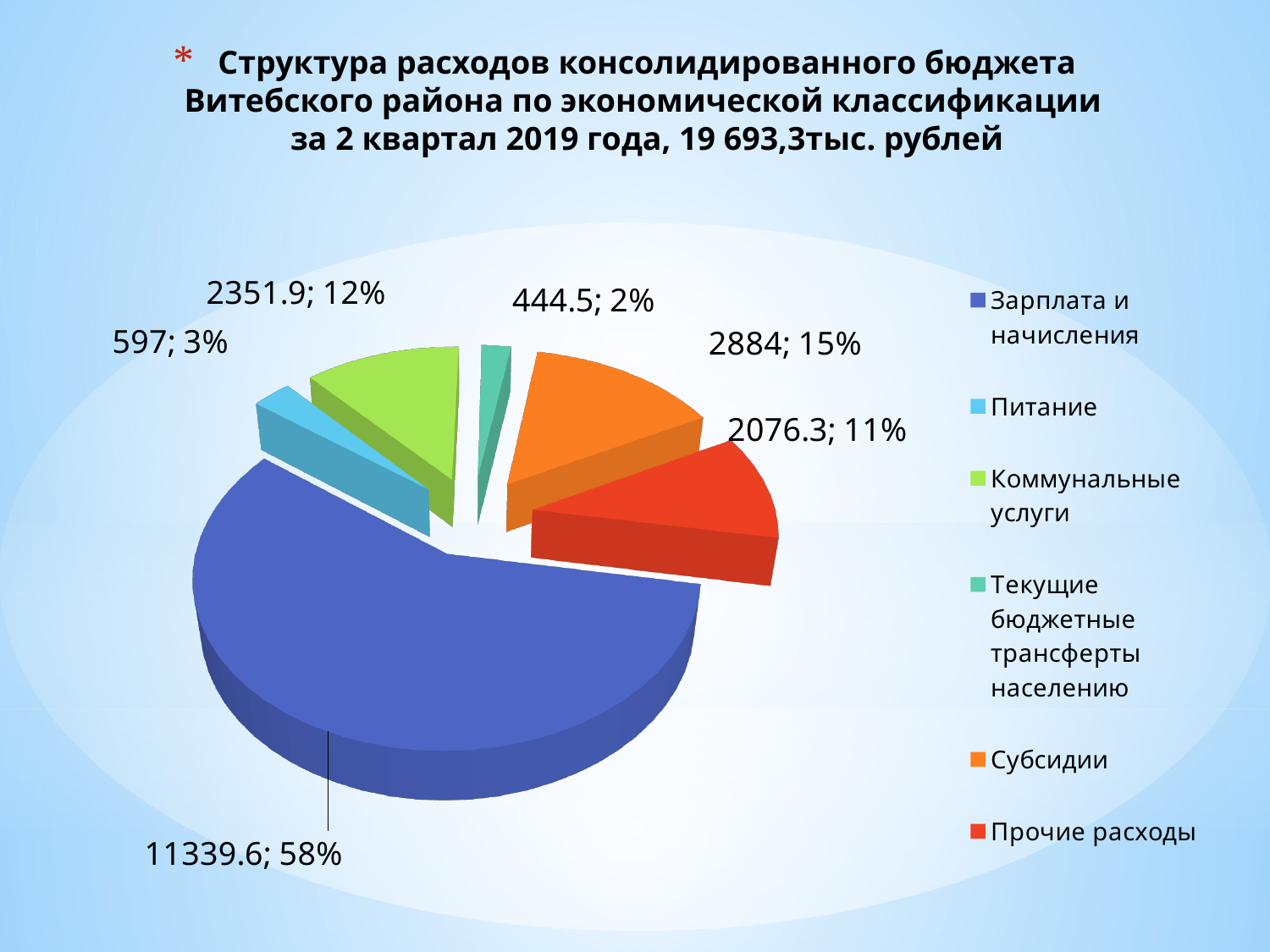
How many slices does the pie chart have? 6 Which is larger, the value for Коммунальные услуги or the value for Прочие расходы? Коммунальные услуги What kind of chart is shown on the slide? Pie chart What is the value shown for Текущие бюджетные трансферты населению? 444.5 Which category has the smallest slice of the pie? Текущие бюджетные трансферты населению Which category has the largest slice of the pie? Зарплата и начисления What percentage share does Питание have? 3% What colour is the slice for Прочие расходы? Red What is the difference between the values for Субсидии and Прочие расходы? 807.7 What percentage share does Субсидии have in the pie chart? 15% What is the value shown for Коммунальные услуги? 2351.9 What is the value shown for Зарплата и начисления? 11339.6